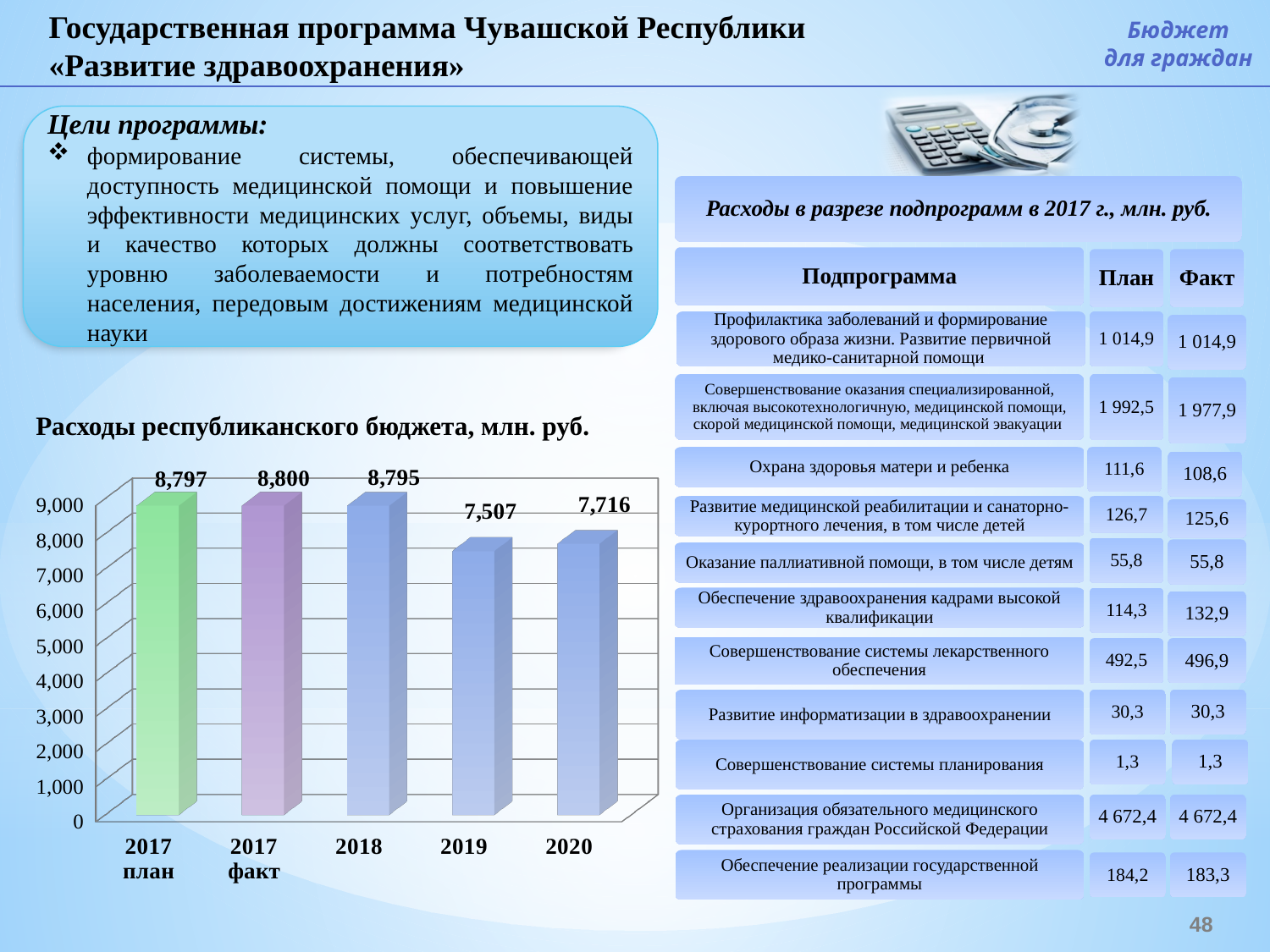
What is the difference between the values for 2020 and 2019? 209 Which category has the lowest value in the chart? 2019 What is the value shown for 2020 in the chart? 7,716 How many bars are plotted in the chart? 5 What is the difference between the values for 2018 and 2019? 1,288 Which is larger, the value for 2019 or the value for 2020? 2020 Which category has the highest value in the chart? 2017 факт What is the value for 2017 план in the chart 'Расходы республиканского бюджета, млн. руб.'? 8,797 Is the value for 2019 greater or less than 8,000? less What is the value for 2017 факт in the chart? 8,800 What is the value shown for 2019 in the chart? 7,507 What kind of chart is shown on the slide? bar chart